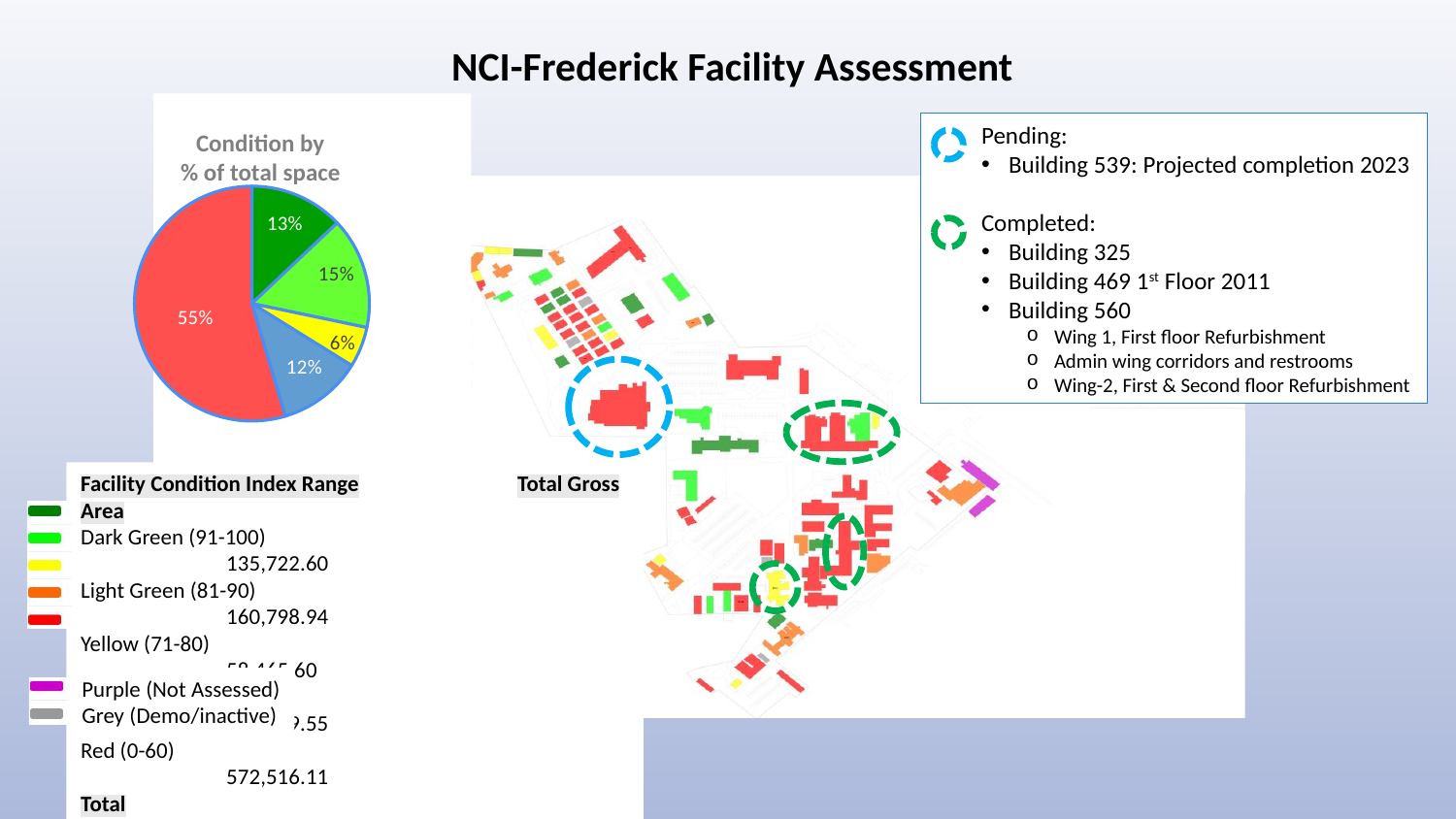
What is the smallest share shown in the pie chart? 6% What percentage is shown for the dark green slice of the pie chart? 13% What is the title of the pie chart? Condition by % of total space What percentage is shown for the light green slice of the pie chart? 15% What is the largest share shown in the pie chart? 55% What percentage is shown for the yellow slice of the pie chart? 6% What is the difference between the light green slice (15%) and the dark green slice (13%) in the pie chart? 2% What percentage is shown for the red slice of the pie chart? 55% How many slices does the pie chart have? 5 Which slice is larger in the pie chart, the dark green slice or the light green slice? light green What is the difference between the red slice (55%) and the blue slice (12%) in the pie chart? 43% What kind of chart is shown on the slide? pie chart